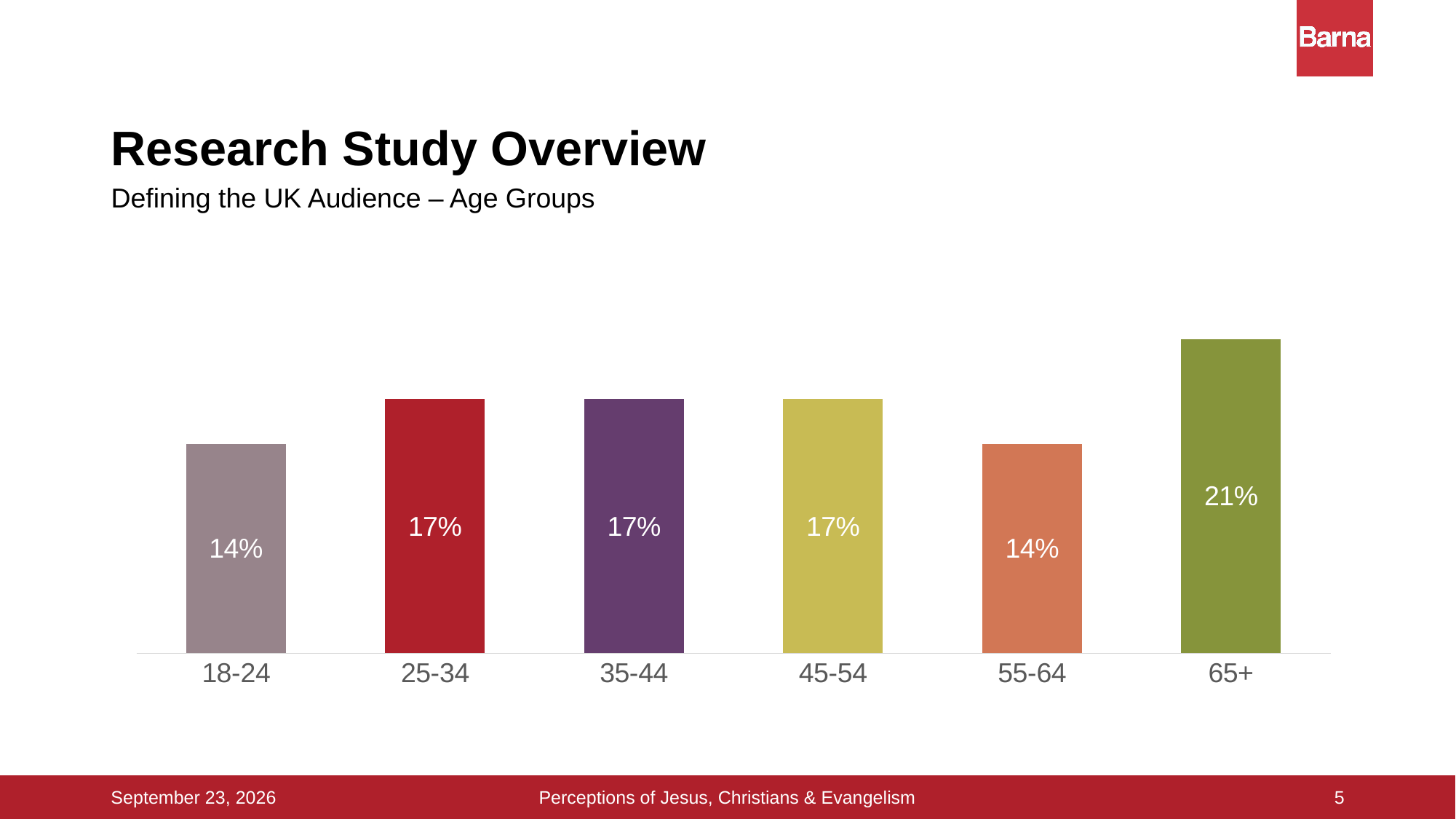
What is the subtitle of the chart on the slide? Defining the UK Audience – Age Groups What kind of chart is shown on the slide? Bar chart What is the value for the 45-54 age group? 17% What is the value for the 65+ age group? 21% What is the difference between the values for 25-34 and 18-24? 3% Which is larger, the value for 35-44 or the value for 55-64? 35-44 What is the value for the 55-64 age group? 14% Which age group has the highest value? 65+ What is the value for the 18-24 age group? 14% What is the difference between the values for 65+ and 55-64? 7% How many age groups have a value of 17%? 3 How many age groups are shown in the chart? 6